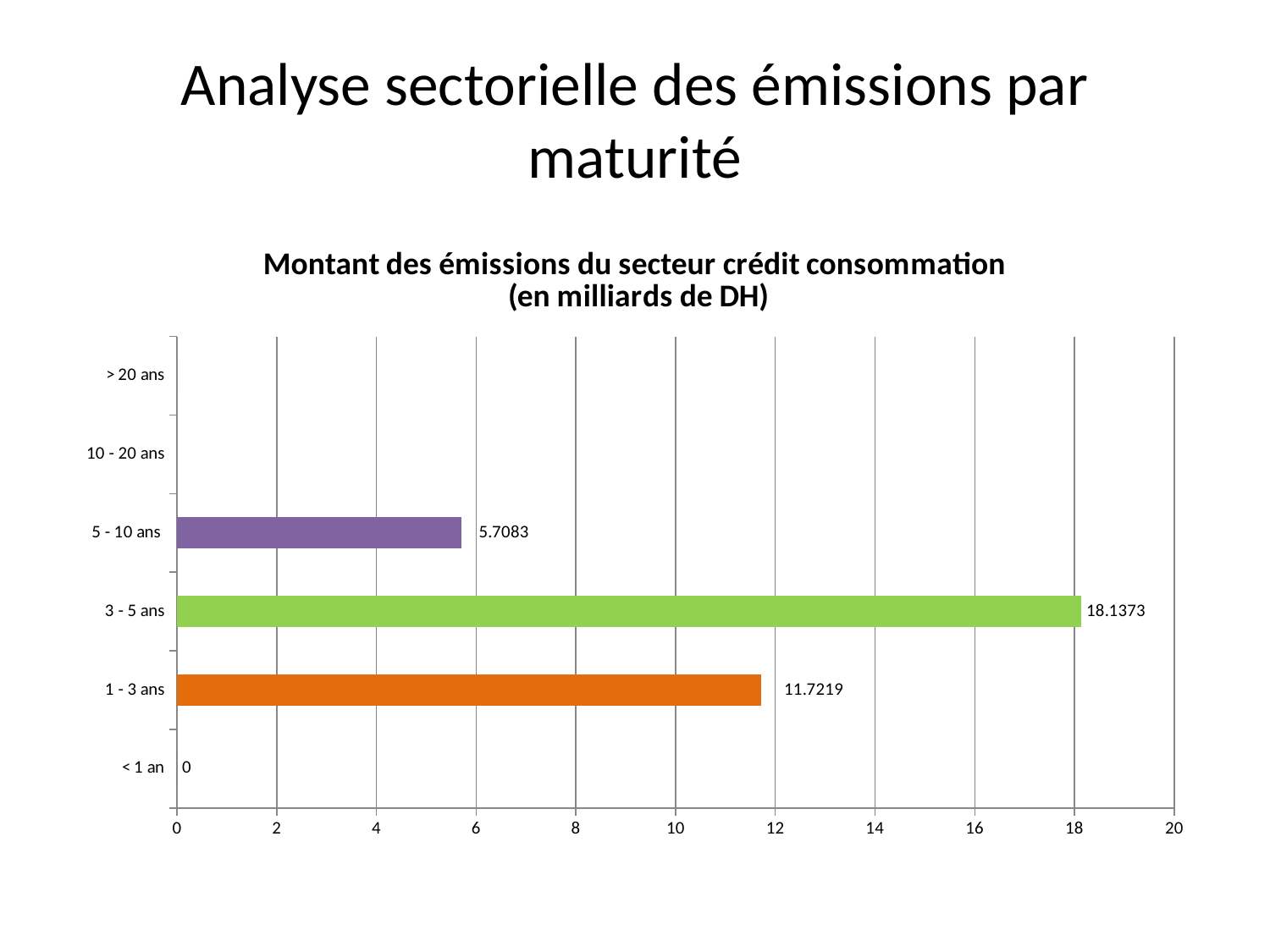
What is the value for the 1 - 3 ans category? 11.7219 What is the value for the < 1 an category? 0 Which is larger, the value for 1 - 3 ans or the value for 5 - 10 ans? 1 - 3 ans What is the difference between the values for 3 - 5 ans and 1 - 3 ans? 6.4154 What kind of chart is shown on the slide? Bar chart How many maturity categories are shown on the y axis? 6 What is the difference between the values for 1 - 3 ans and 5 - 10 ans? 6.0136 What is the value for the 5 - 10 ans category? 5.7083 Is the value for 3 - 5 ans greater or less than 16? greater What is the title of the chart? Montant des émissions du secteur crédit consommation (en milliards de DH) What is the value for the 3 - 5 ans category? 18.1373 Which maturity category has the highest value? 3 - 5 ans